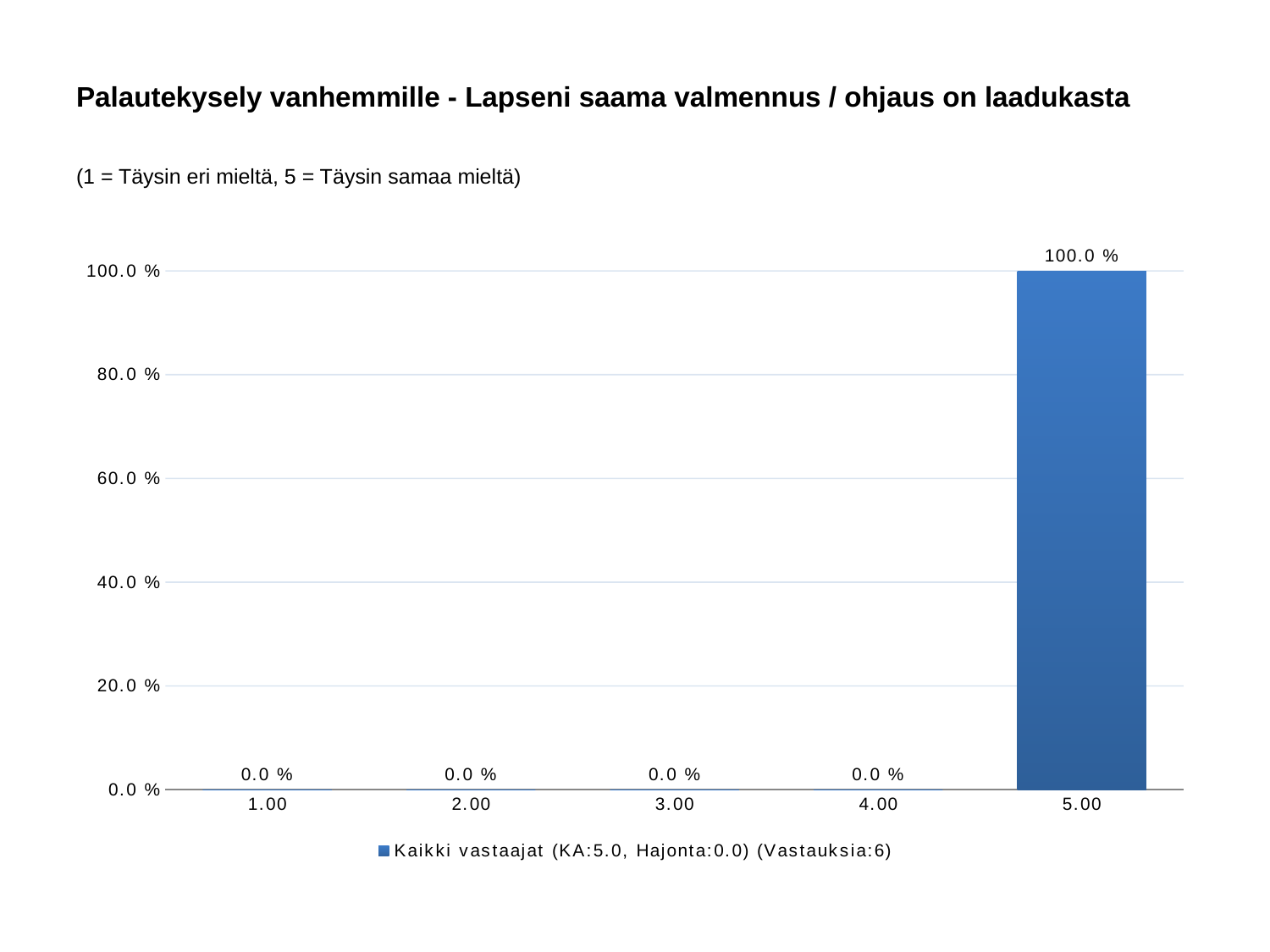
What is the value for category 5.00? 100.0 % Do the values rise or fall from category 1.00 to category 5.00? rise What is the legend entry for the series? Kaikki vastaajat (KA:5.0, Hajonta:0.0) (Vastauksia:6) What is the difference between the values for 5.00 and 4.00? 100.0 % What kind of chart is shown? bar chart Which has the larger value, category 2.00 or category 5.00? 5.00 What is the value for category 3.00? 0.0 % Is the value for 5.00 greater or less than 80.0 %? greater Which category has the highest value? 5.00 How many categories are shown on the x axis? 5 How many series does the legend list? 1 What is the value for category 1.00? 0.0 %